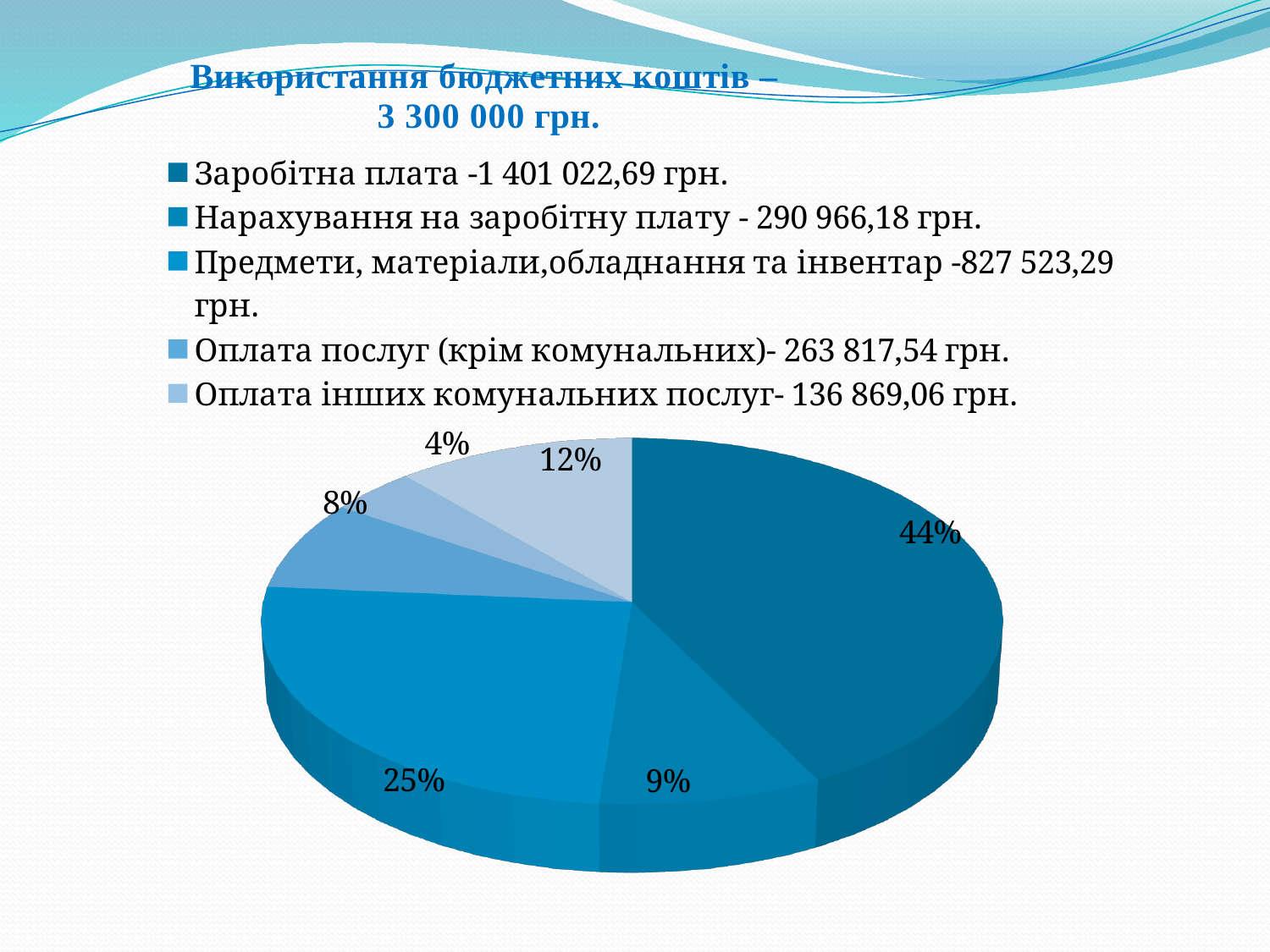
What kind of chart is shown on the slide? pie chart Which slice is larger, the one labelled 12% or the one labelled 9%? 12% What is the difference in percentage points between the 44% slice and the 25% slice? 19 What amount is given in the legend for Оплата інших комунальних послуг? 136 869,06 грн. How many slices does the pie chart have? 6 How many entries does the legend list? 5 What is the smallest percentage shown on the pie chart? 4% What is the largest percentage shown on the pie chart? 44% What share of the pie does the slice for Предмети, матеріали, обладнання та інвентар take? 25% What amount is given in the legend for Нарахування на заробітну плату? 290 966,18 грн. What share of the pie does the slice for Заробітна плата take? 44% What total amount is stated in the chart title? 3 300 000 грн.